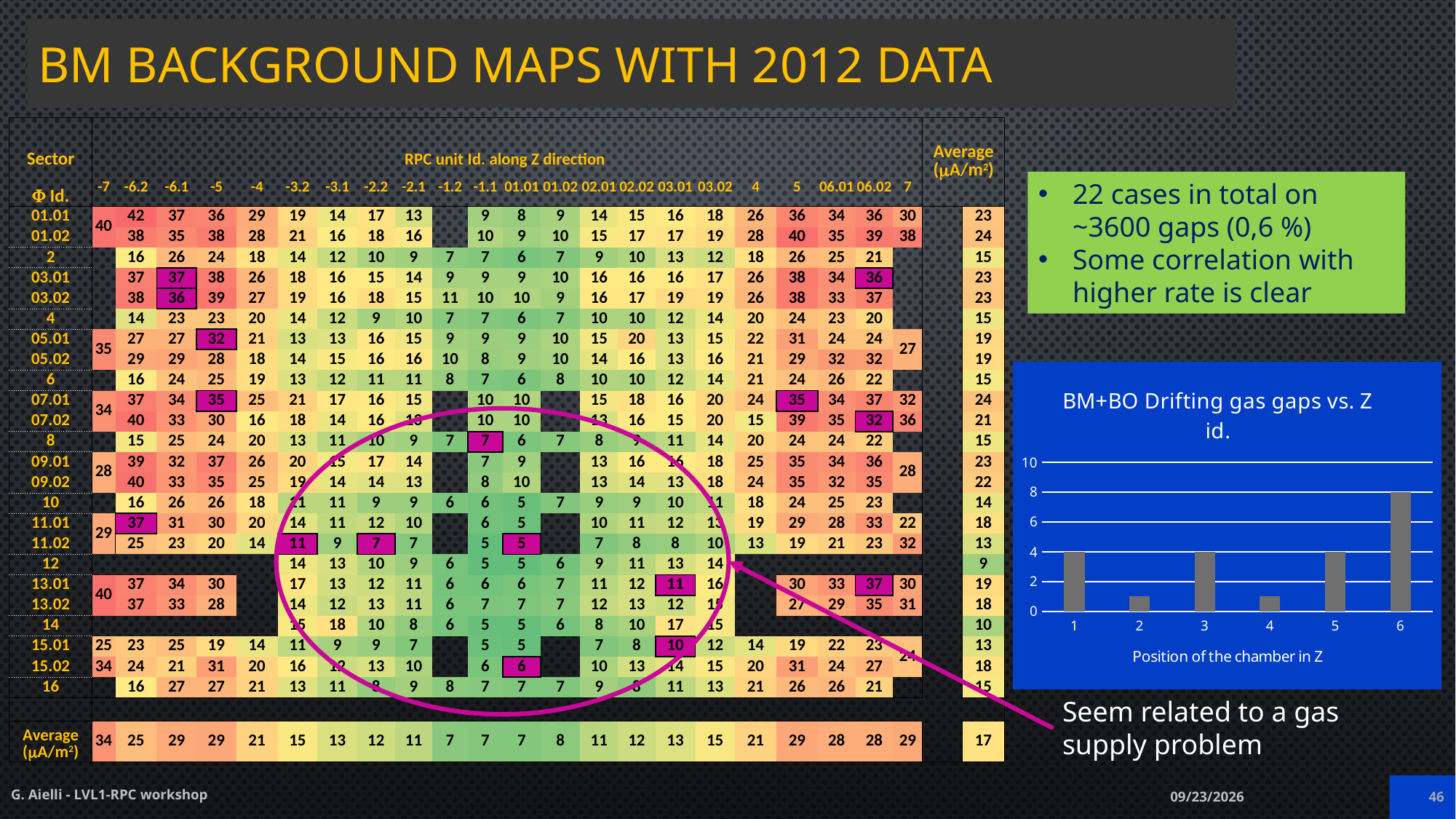
In the 'BM+BO Drifting gas gaps vs. Z id.' chart, which has the larger value, position 1 or position 2? 1 In the 'BM+BO Drifting gas gaps vs. Z id.' chart, what is the value for position 6? 8 In the 'BM+BO Drifting gas gaps vs. Z id.' chart, what is the value for position 1? 4 In the 'BM+BO Drifting gas gaps vs. Z id.' chart, which has the larger value, position 5 or position 6? 6 How many positions (categories) are shown on the x axis of the 'BM+BO Drifting gas gaps vs. Z id.' chart? 6 In the 'BM+BO Drifting gas gaps vs. Z id.' chart, is the value for position 4 greater or less than 2? less In the 'BM+BO Drifting gas gaps vs. Z id.' chart, which position in Z has the highest number of drifting gas gaps? 6 In the 'BM+BO Drifting gas gaps vs. Z id.' chart, what is the value for position 3? 4 What kind of chart is the 'BM+BO Drifting gas gaps vs. Z id.' chart? bar chart In the 'BM+BO Drifting gas gaps vs. Z id.' chart, what is the difference between the values for position 6 and position 1? 4 What is the x-axis title of the 'BM+BO Drifting gas gaps vs. Z id.' chart? Position of the chamber in Z In the 'BM+BO Drifting gas gaps vs. Z id.' chart, is the value for position 2 greater or less than 2? less